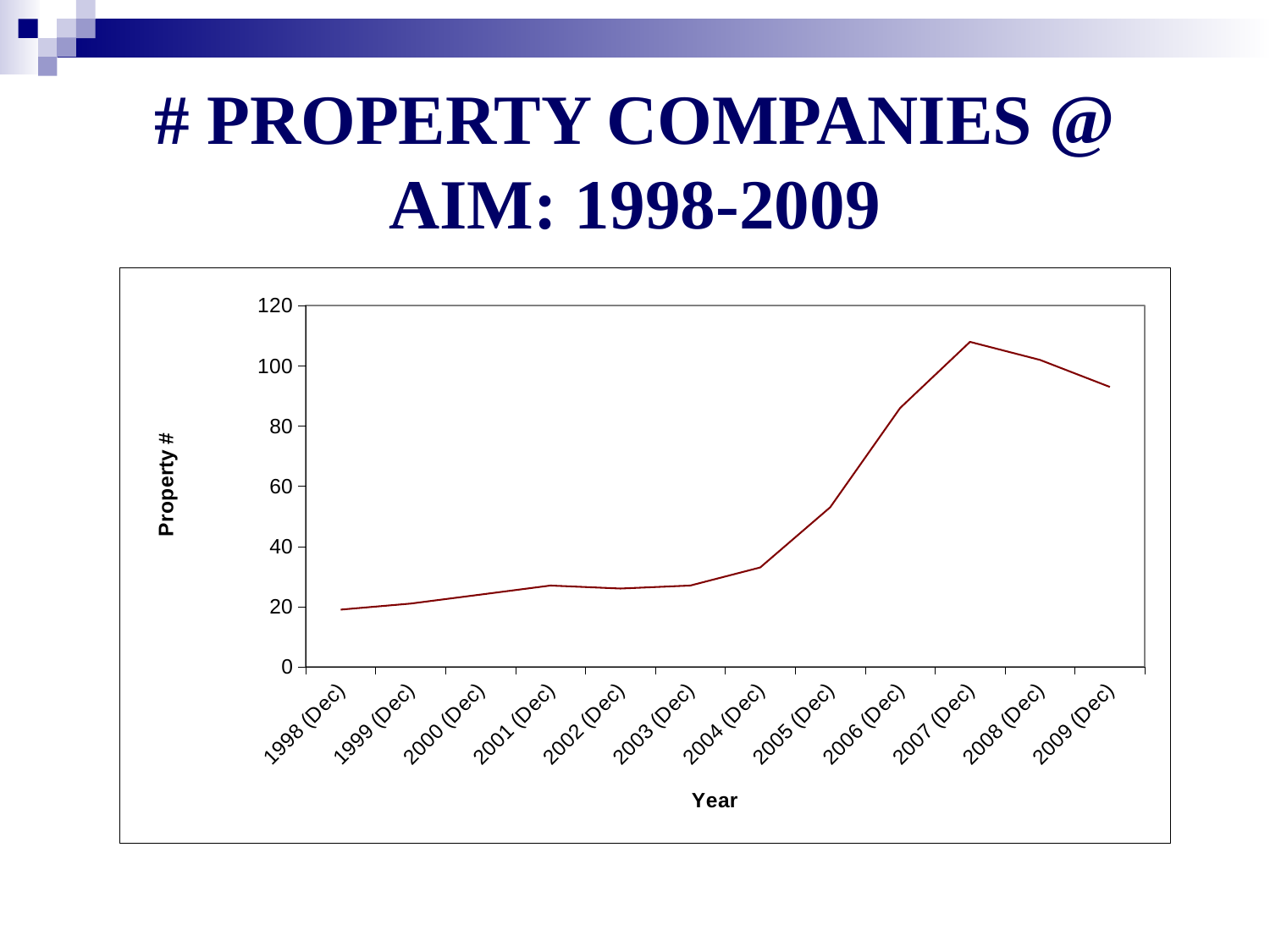
Which is larger, the value for 2005 (Dec) or 2006 (Dec)? 2006 (Dec) What is the label on the vertical axis of the chart? Property # What kind of chart is shown on the slide? line chart Does the number of property companies rise or fall between 2007 (Dec) and 2009 (Dec)? fall In which year is the number of property companies highest? 2007 (Dec) Is the value for 2005 (Dec) greater or less than 60? less Is the value for 2009 (Dec) greater or less than 100? less Is the value for 2004 (Dec) greater or less than 40? less How many data points (years) are plotted on the chart? 12 In which year is the number of property companies lowest? 1998 (Dec)